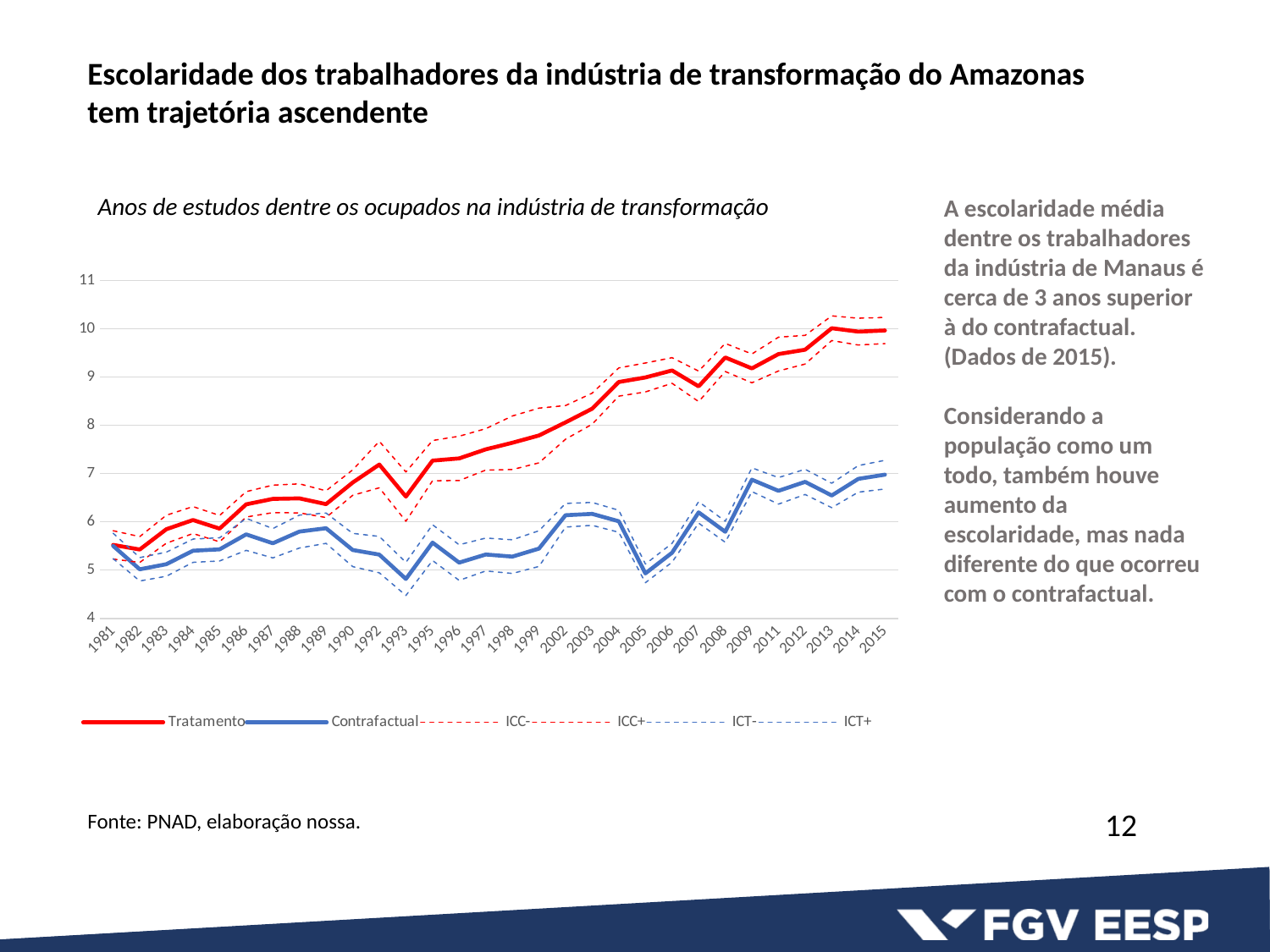
Is the value for Contrafactual in 2015 greater or less than 8? less Is the value for Tratamento in 2015 greater or less than 9? greater What kind of chart is shown on the slide? line chart What is the title of the chart? Anos de estudos dentre os ocupados na indústria de transformação How many series does the legend list? 6 How many years are shown on the x axis? 30 Is the value for Tratamento in 1981 greater or less than 6? less In 2015, which is larger, Tratamento or Contrafactual? Tratamento Which series is drawn as a solid red line? Tratamento For Tratamento, which is larger, the value in 1993 or the value in 2004? 2004 Does the Tratamento series generally rise or fall from 1981 to 2015? rise